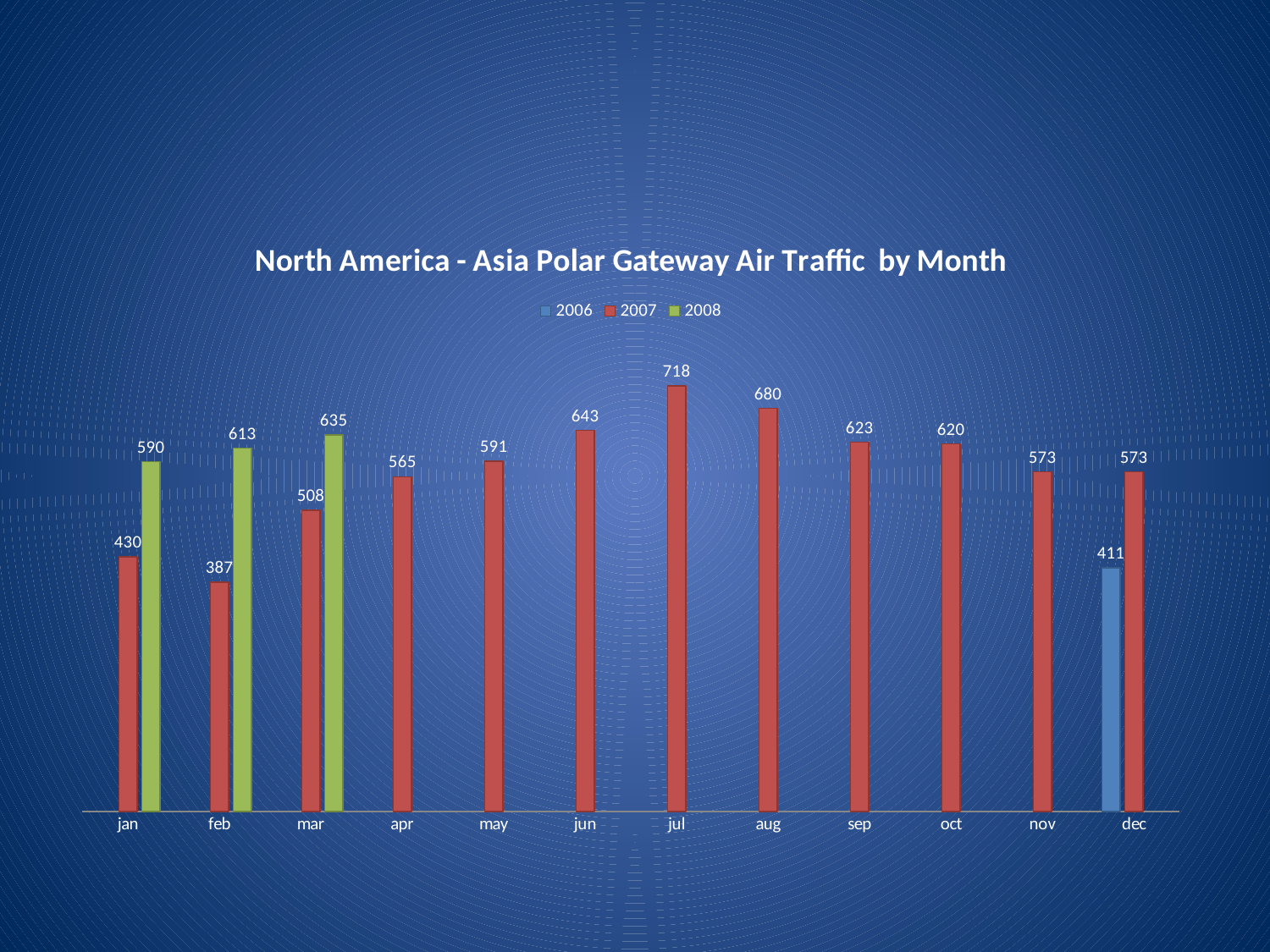
What is the difference between the 2008 and 2007 values for jan? 160 What is the 2006 value for dec? 411 Do the 2007 values rise or fall from apr to jul? rise How many series does the legend list? 3 How many months are shown on the x axis? 12 Which is larger, the 2007 value for aug or the 2007 value for sep? aug What kind of chart is shown? bar chart Which month has the lowest 2007 value? feb What is the title of the chart? North America - Asia Polar Gateway Air Traffic by Month What is the 2008 value for mar? 635 What is the 2007 value for jul? 718 Which month has the highest 2007 value? jul